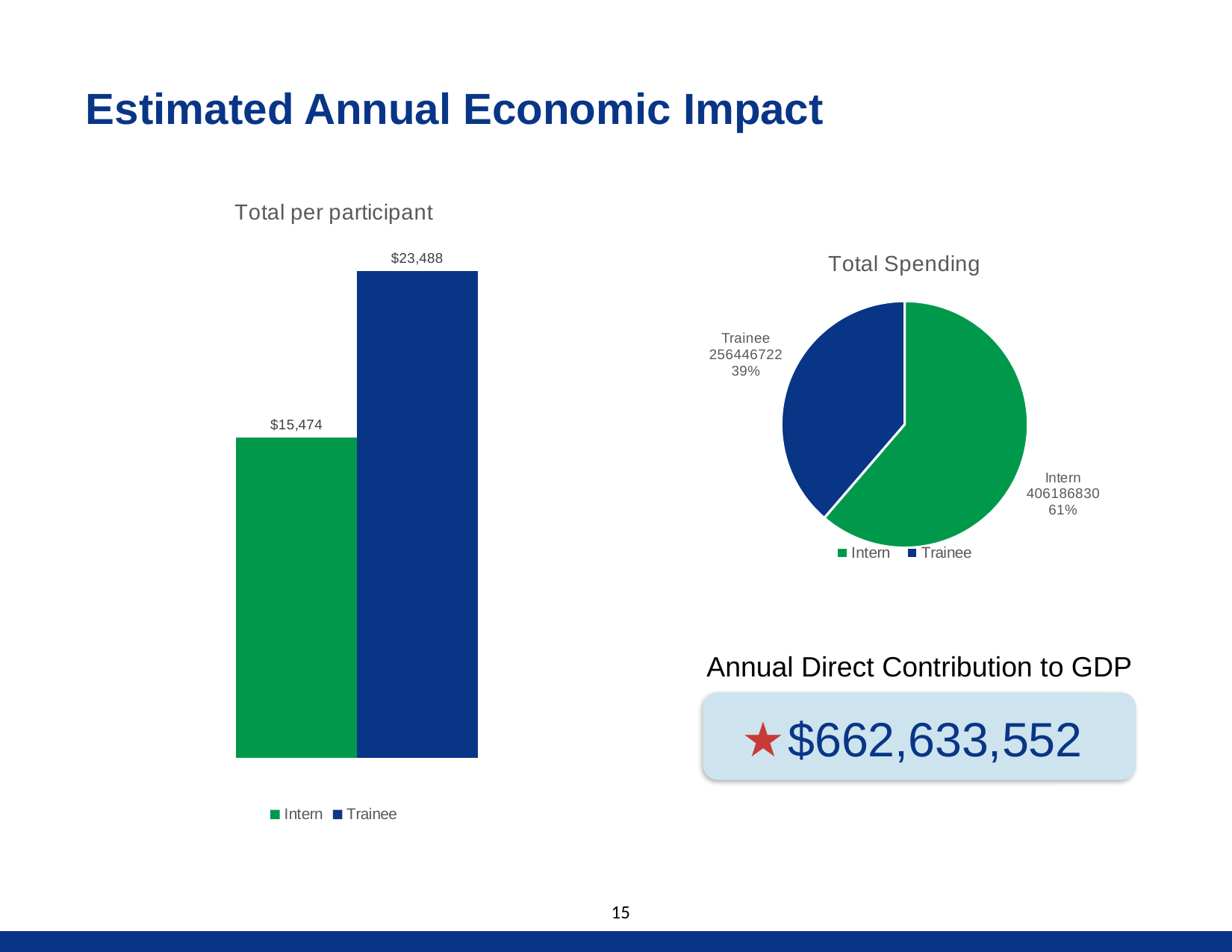
How many series does the legend of the 'Total per participant' chart list? 2 In the 'Total per participant' chart, what is the difference between the Trainee and Intern values? $8,014 In the 'Total Spending' chart, which colour represents Intern? Green In the 'Total Spending' chart, what is the value shown for Trainee? 256446722 What kind of chart is the 'Total Spending' chart? Pie chart In the 'Total Spending' chart, what share of the pie does Intern represent? 61% In the 'Total per participant' chart, what is the value for Trainee? $23,488 In the 'Total Spending' chart, what share of the pie does Trainee represent? 39% In the 'Total Spending' chart, what is the value shown for Intern? 406186830 In the 'Total per participant' chart, which category has the higher value? Trainee In the 'Total per participant' chart, what is the value for Intern? $15,474 What kind of chart is the 'Total per participant' chart? Bar chart